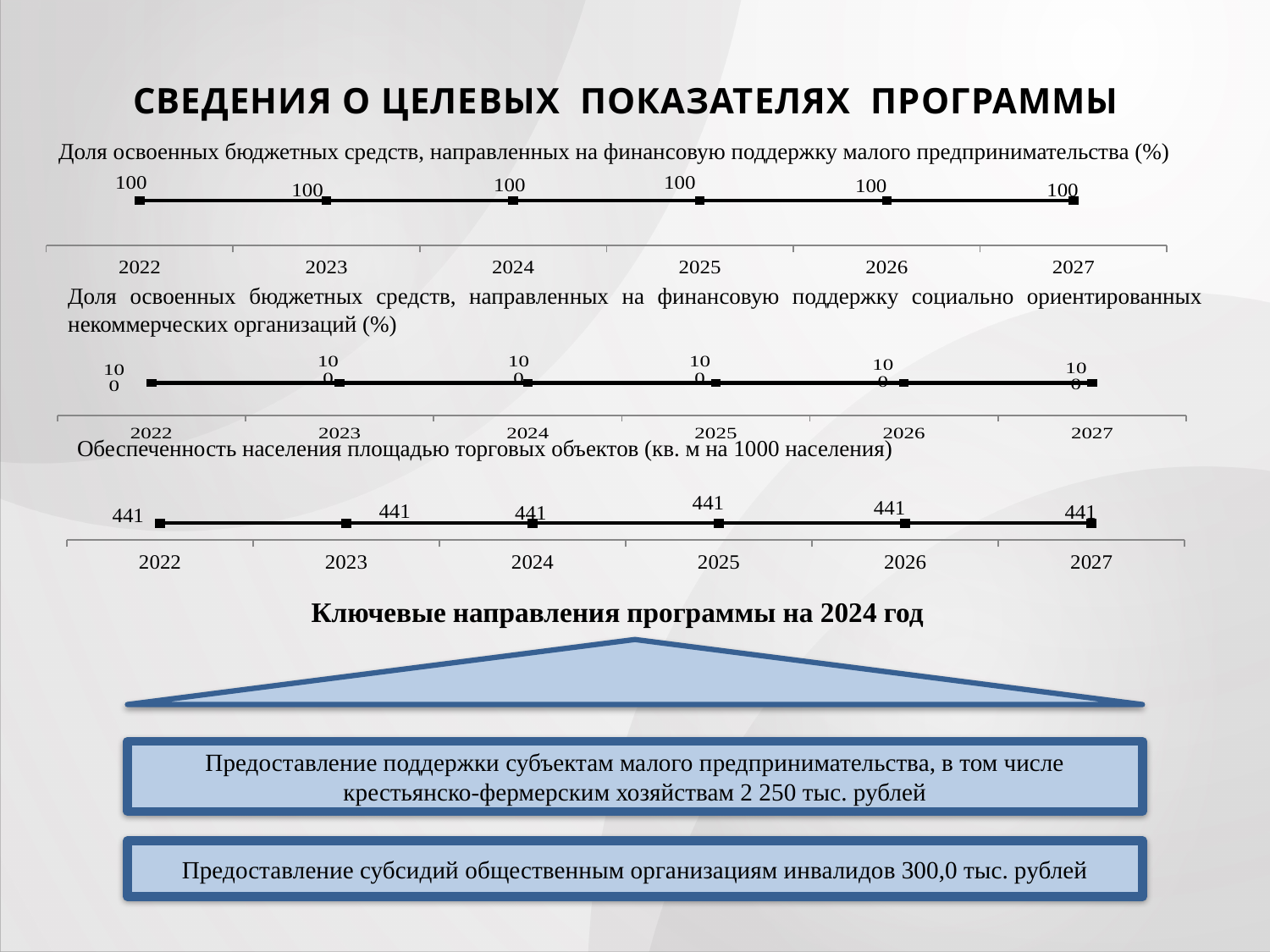
In the bottom chart on the slide, do the values rise, fall or stay the same across the years? stay the same In the chart 'Обеспеченность населения площадью торговых объектов (кв. м на 1000 населения)', what is the value for 2022? 441 In the bottom chart on the slide, what is the difference between the values for 2027 and 2022? 0 In the chart 'Обеспеченность населения площадью торговых объектов (кв. м на 1000 населения)', what is the value for 2025? 441 In the chart 'Доля освоенных бюджетных средств, направленных на финансовую поддержку малого предпринимательства (%)', what is the value for 2027? 100 In the chart 'Доля освоенных бюджетных средств, направленных на финансовую поддержку малого предпринимательства (%)', what is the value for 2024? 100 In the middle chart on the slide, what is the difference between the values for 2023 and 2026? 0 In the chart 'Доля освоенных бюджетных средств, направленных на финансовую поддержку социально ориентированных некоммерческих организаций (%)', what is the value for 2022? 100 What kind of chart is the top chart on the slide? line chart How many charts are shown on the slide? 3 In the top chart on the slide, how many years are plotted along the x axis? 6 In the top chart on the slide, do the values rise, fall or stay the same from 2022 to 2027? stay the same